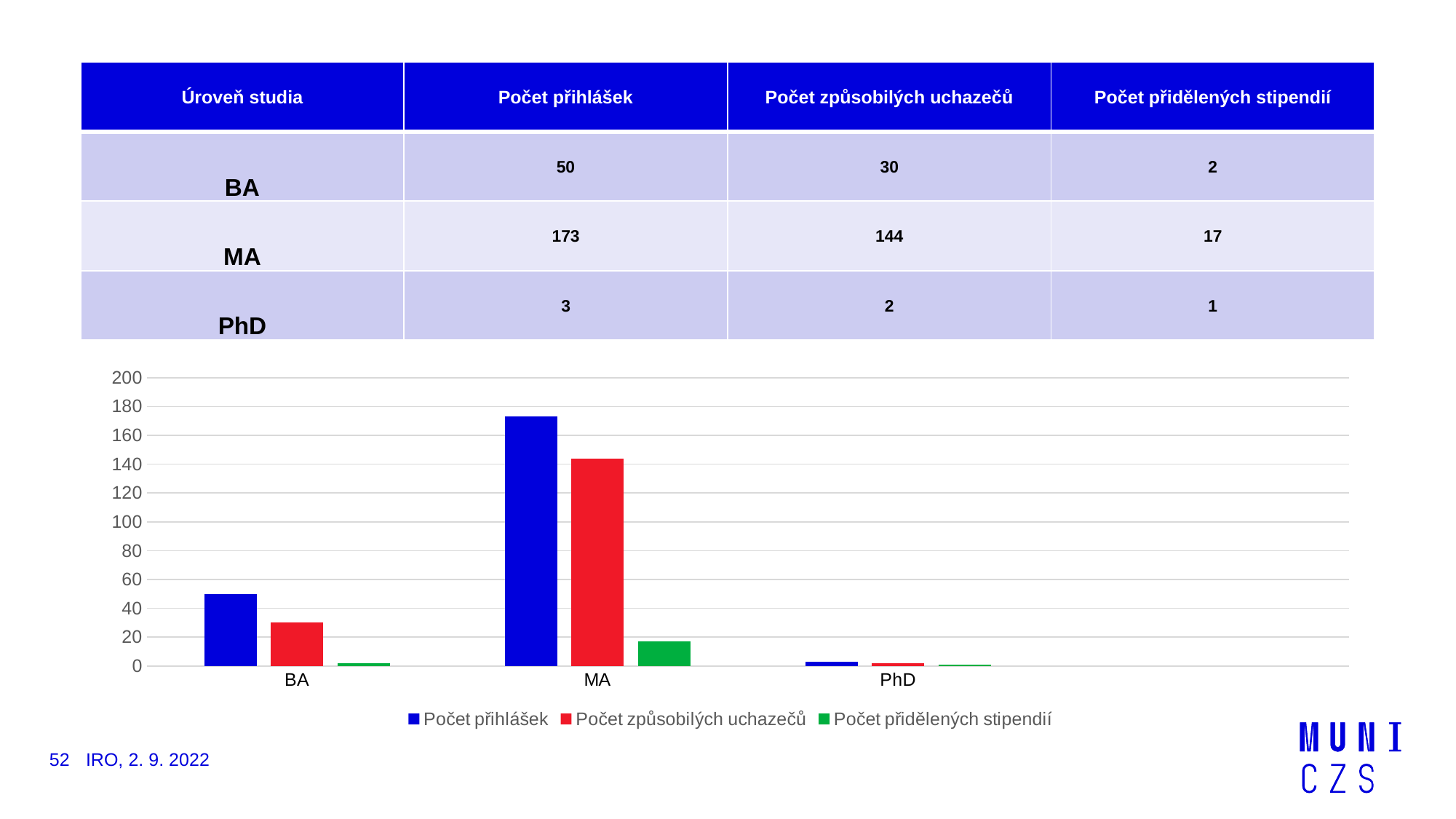
Is the value of Počet způsobilých uchazečů for MA greater or less than 140? greater Which is larger for BA: Počet přihlášek or Počet způsobilých uchazečů? Počet přihlášek What kind of chart is shown on the slide? bar chart What is the value of Počet přihlášek for MA? 173 Which category has the highest value of Počet přihlášek? MA What is the value of Počet přidělených stipendií for PhD? 1 Which colour represents Počet přidělených stipendií in the chart? green Which category has the lowest value of Počet způsobilých uchazečů? PhD How many categories are shown on the x axis of the chart? 3 What is the value of Počet způsobilých uchazečů for BA? 30 How many series does the chart legend list? 3 What is the difference between Počet přihlášek and Počet způsobilých uchazečů for MA? 29